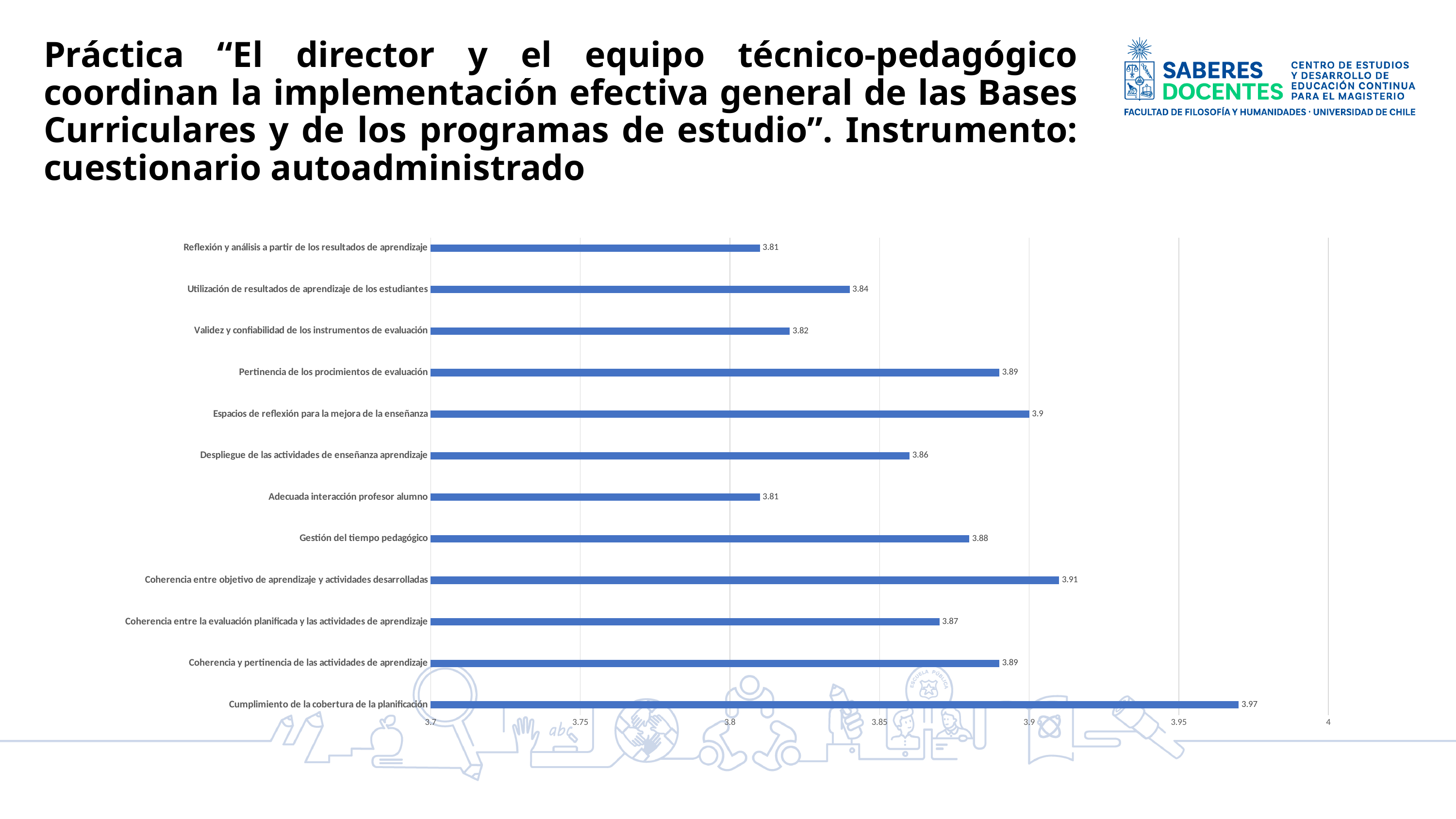
What is the value for Gestión del tiempo pedagógico? 3.88 Which category has the highest value? Cumplimiento de la cobertura de la planificación What is the value for Espacios de reflexión para la mejora de la enseñanza? 3.9 Which is larger: the value for Gestión del tiempo pedagógico or the value for Despliegue de las actividades de enseñanza aprendizaje? Gestión del tiempo pedagógico Is the value for Utilización de resultados de aprendizaje de los estudiantes greater or less than 3.8? greater What is the difference between the values for Coherencia entre objetivo de aprendizaje y actividades desarrolladas and Utilización de resultados de aprendizaje de los estudiantes? 0.07 What is the lowest value shown in the chart? 3.81 What kind of chart is shown on the slide? bar chart What is the difference between the values for Cumplimiento de la cobertura de la planificación and Adecuada interacción profesor alumno? 0.16 What is the value for Validez y confiabilidad de los instrumentos de evaluación? 3.82 How many categories are shown in the chart? 12 What is the value for Cumplimiento de la cobertura de la planificación? 3.97